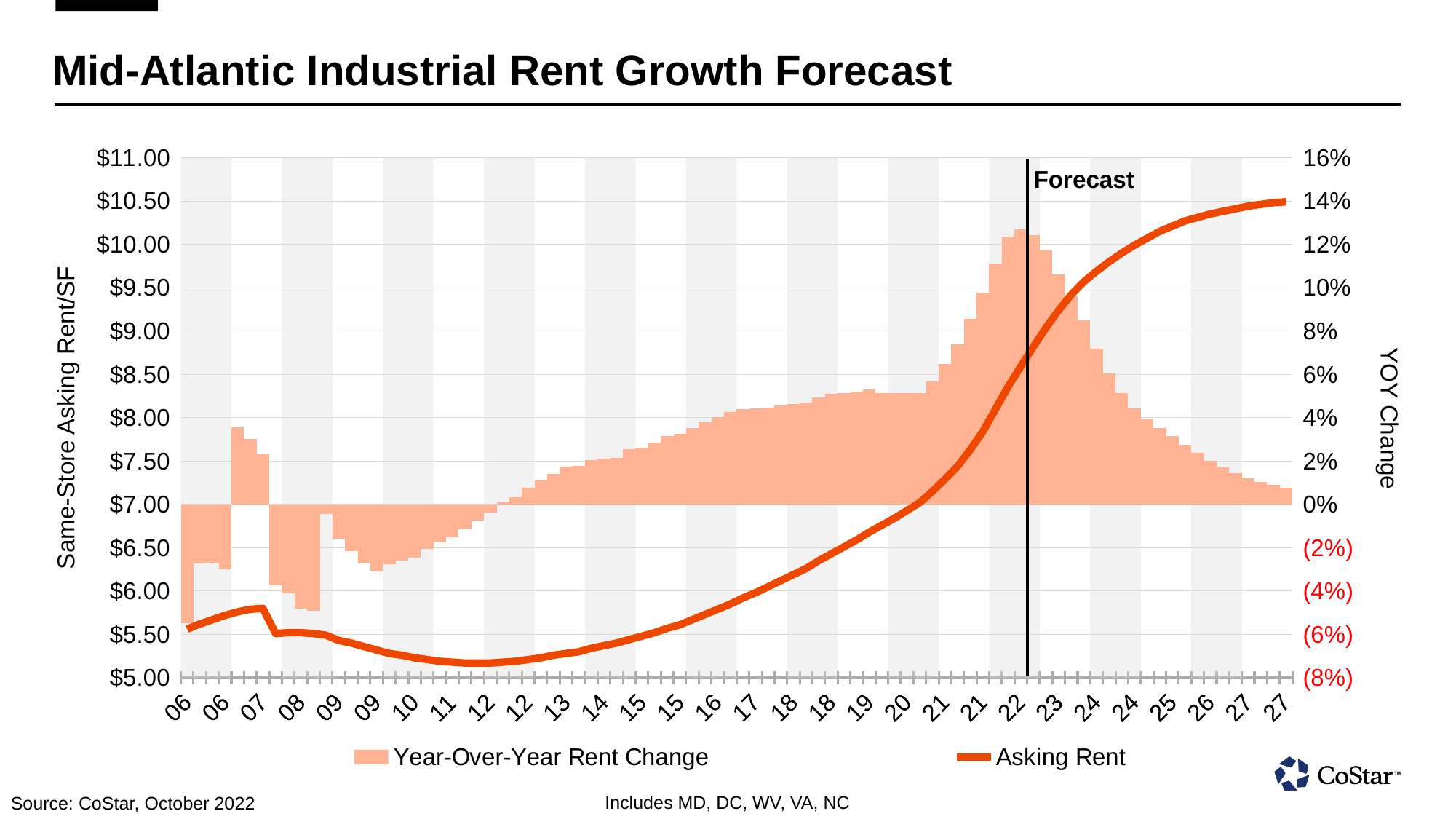
Is the Year-Over-Year Rent Change at the last 27 point greater or less than 2%? less Does the Asking Rent line rise or fall from 12 to 27? rise What is the title of the chart? Mid-Atlantic Industrial Rent Growth Forecast Is the Asking Rent value at 12 greater or less than $5.50? less What kind of chart is shown on the slide? bar and line chart Is the Year-Over-Year Rent Change at 09 greater or less than 0%? less How many series does the legend list? 2 In which year does the Year-Over-Year Rent Change reach its highest value? 22 Which series is drawn as a line? Asking Rent